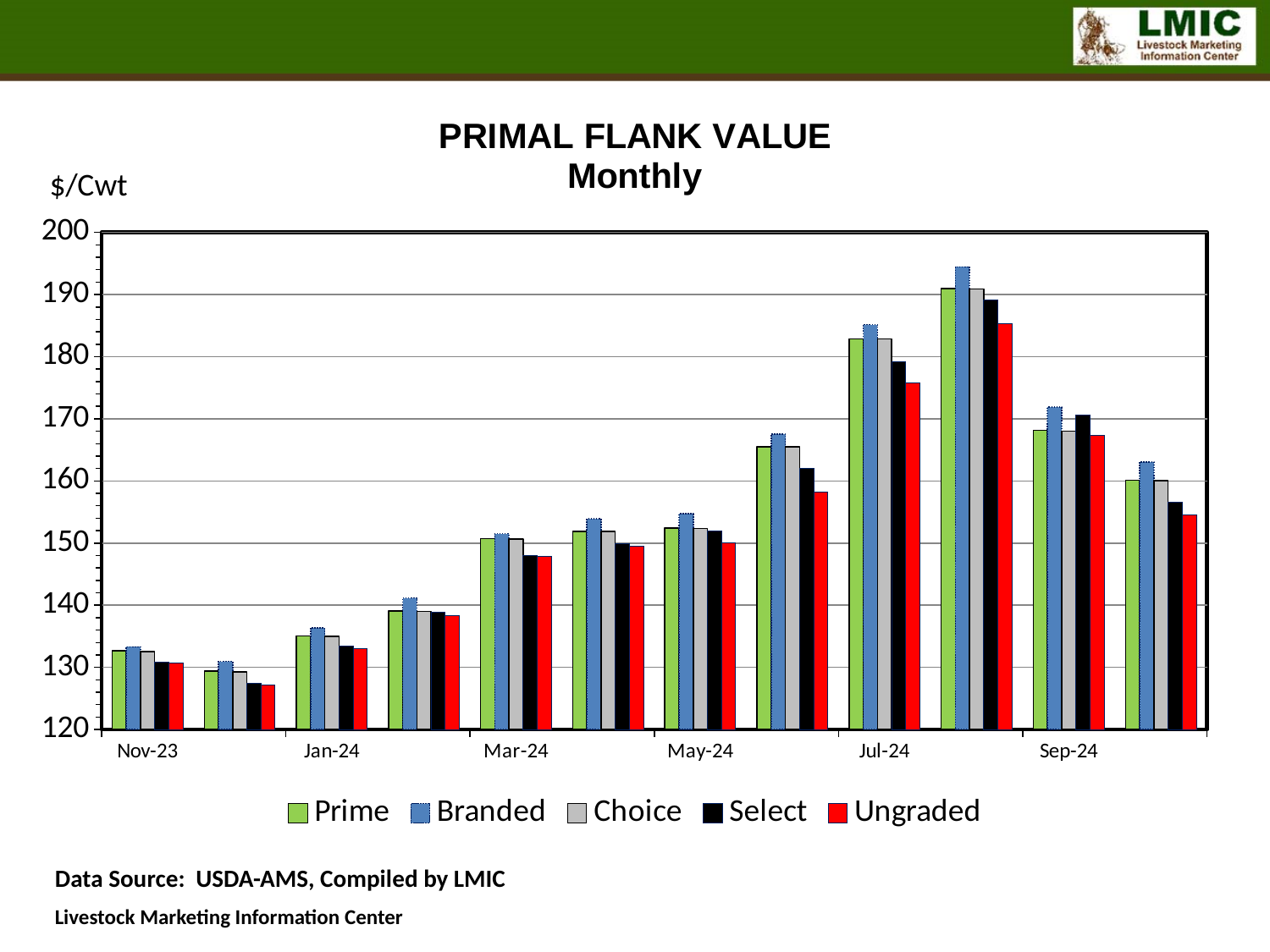
Which is larger, the Prime value for Nov-23 or the Prime value for Jan-24? Jan-24 In Jul-24, which series has the lowest value? Ungraded What kind of chart is shown on the slide? bar chart How many series does the legend list? 5 Do the Prime values rise or fall from Nov-23 to Jul-24? rise Is the Prime value for Sep-24 greater or less than 160? greater Is the Select value for Mar-24 greater or less than 150? less Is the Branded value for Jul-24 greater or less than 180? greater What unit is shown on the y axis of the chart? $/Cwt In Jul-24, which is larger, the Branded value or the Ungraded value? Branded